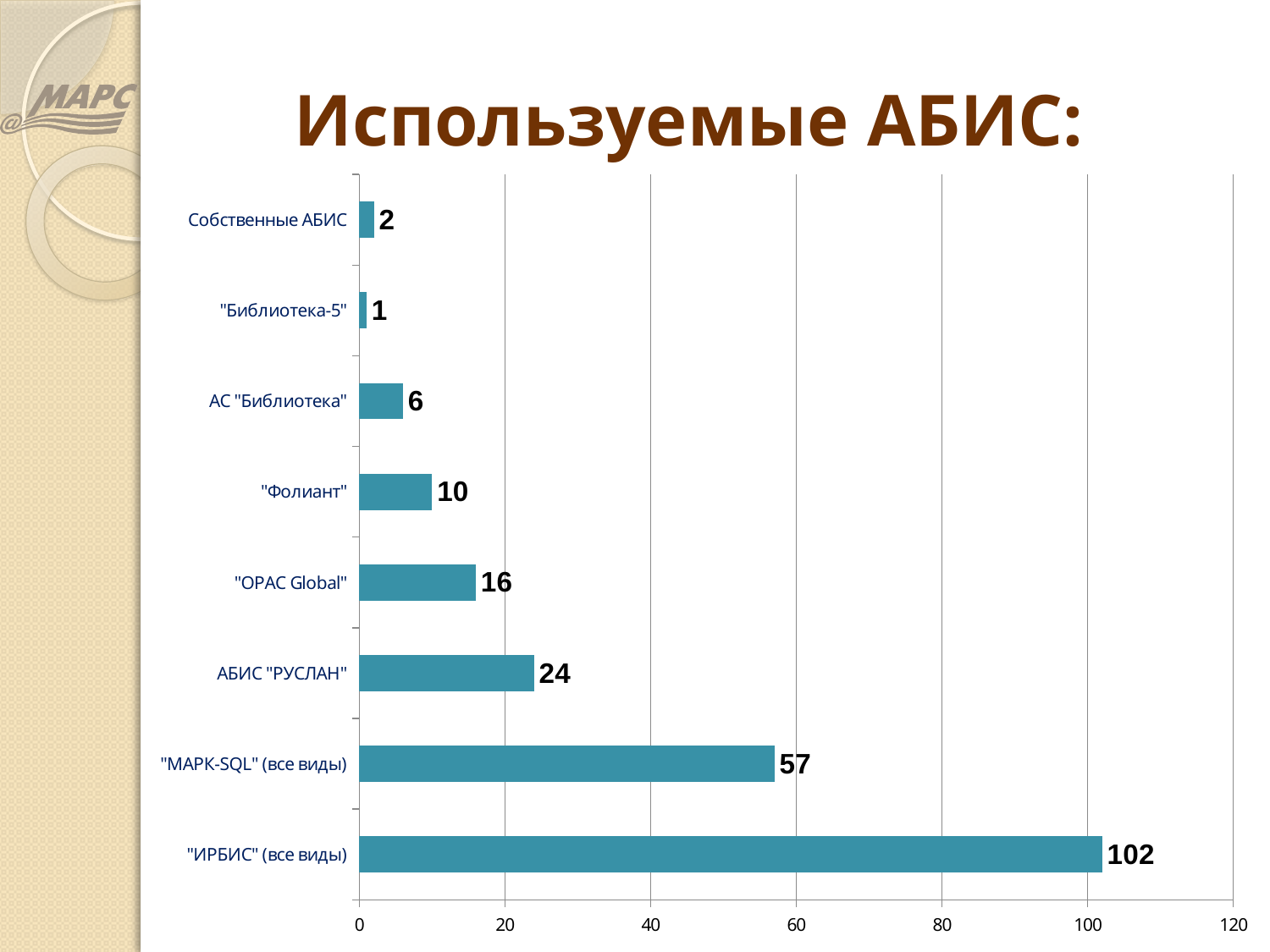
Which is larger, the value for АБИС "РУСЛАН" or the value for "OPAC Global"? АБИС "РУСЛАН" What kind of chart is shown on the slide? bar chart What is the value for "МАРК-SQL" (все виды)? 57 Which category has the lowest value? "Библиотека-5" What is the value for "ИРБИС" (все виды)? 102 What is the difference between the values for АС "Библиотека" and Собственные АБИС? 4 How many categories are shown in the chart? 8 What is the difference between the values for "ИРБИС" (все виды) and "МАРК-SQL" (все виды)? 45 Which category has the highest value? "ИРБИС" (все виды) Is the value for "МАРК-SQL" (все виды) greater or less than 40? greater What is the value for "Фолиант"? 10 What is the title of the slide? Используемые АБИС: